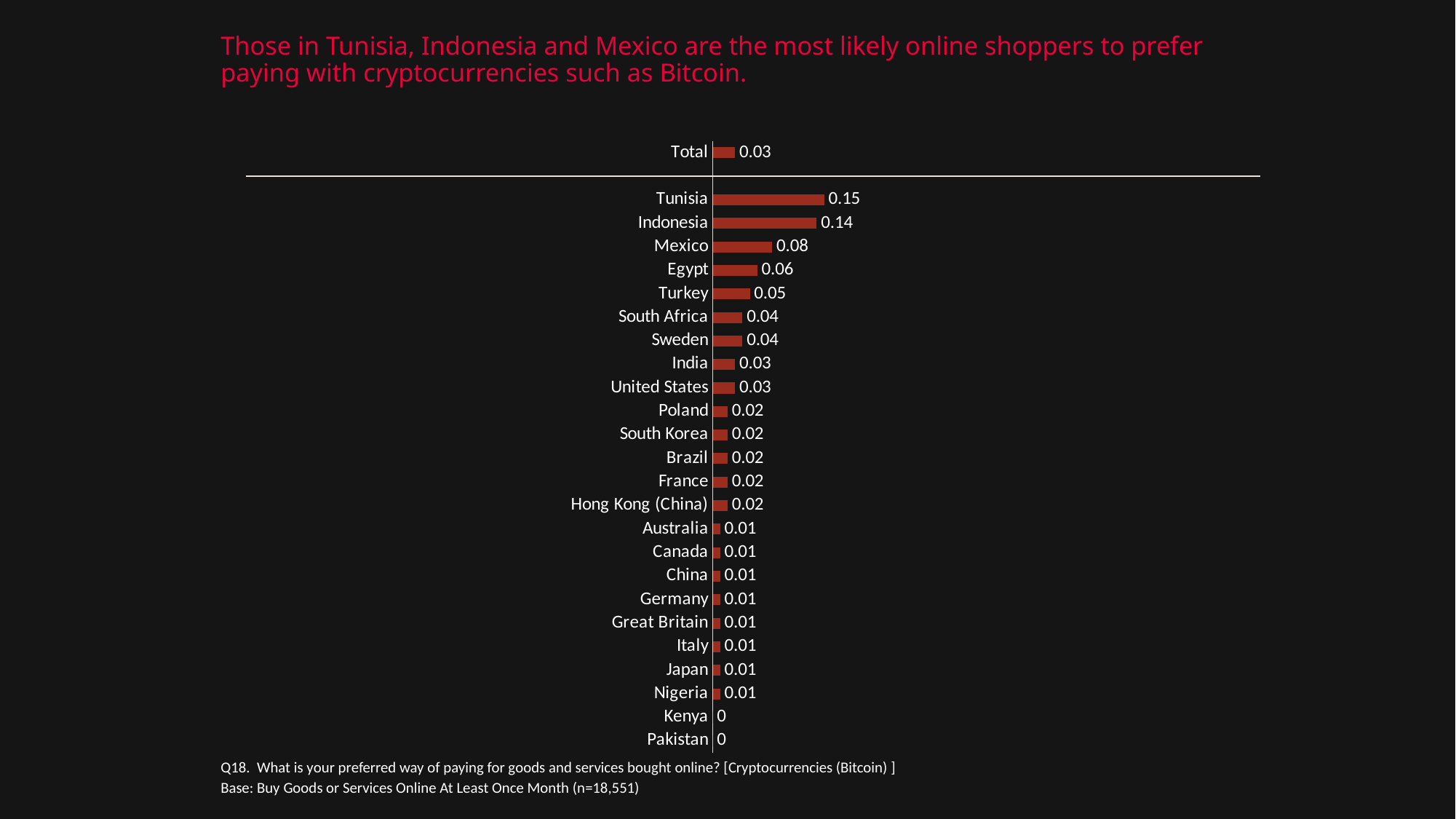
Which has a larger value, Egypt or Poland? Egypt Which country has the highest value? Tunisia What is the value for Tunisia? 0.15 What is the value for Mexico? 0.08 How many countries are listed below the Total bar? 24 What is the value shown for Total? 0.03 Which has a larger value, Turkey or South Africa? Turkey What kind of chart is shown on the slide? Bar chart What is the difference between the values for Mexico and Egypt? 0.02 Which two countries show a value of 0? Kenya and Pakistan What is the difference between the values for Tunisia and Indonesia? 0.01 What is the value for Sweden? 0.04